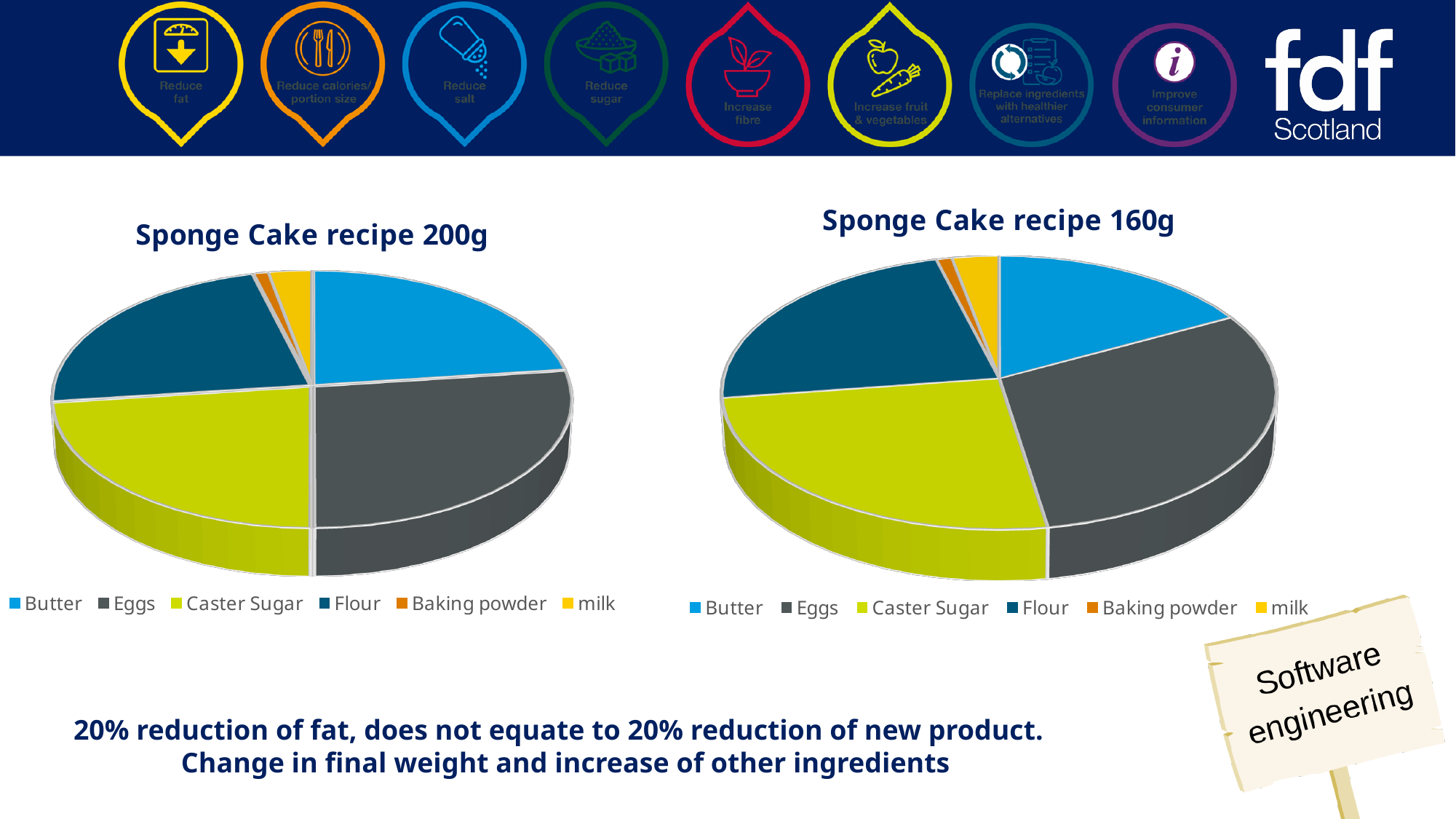
In the 'Sponge Cake recipe 160g' chart, which ingredient has the largest slice? Eggs In the 'Sponge Cake recipe 200g' chart, which slice is larger, Flour or milk? Flour What kind of chart is the 'Sponge Cake recipe 200g' chart? pie chart In the 'Sponge Cake recipe 160g' chart, which ingredient has the smallest slice? Baking powder In the 'Sponge Cake recipe 160g' chart, which slice is larger, milk or Baking powder? milk How many slices does the 'Sponge Cake recipe 200g' pie chart have? 6 How many entries does the legend of the 'Sponge Cake recipe 160g' chart list? 6 What kind of chart is the 'Sponge Cake recipe 160g' chart? pie chart In the 'Sponge Cake recipe 200g' chart, which ingredient has the smallest slice? Baking powder In the 'Sponge Cake recipe 200g' chart, which ingredient is shown in light blue? Butter In the 'Sponge Cake recipe 160g' chart, which slice is larger, Butter or Eggs? Eggs What is the title of the pie chart on the left of the slide? Sponge Cake recipe 200g